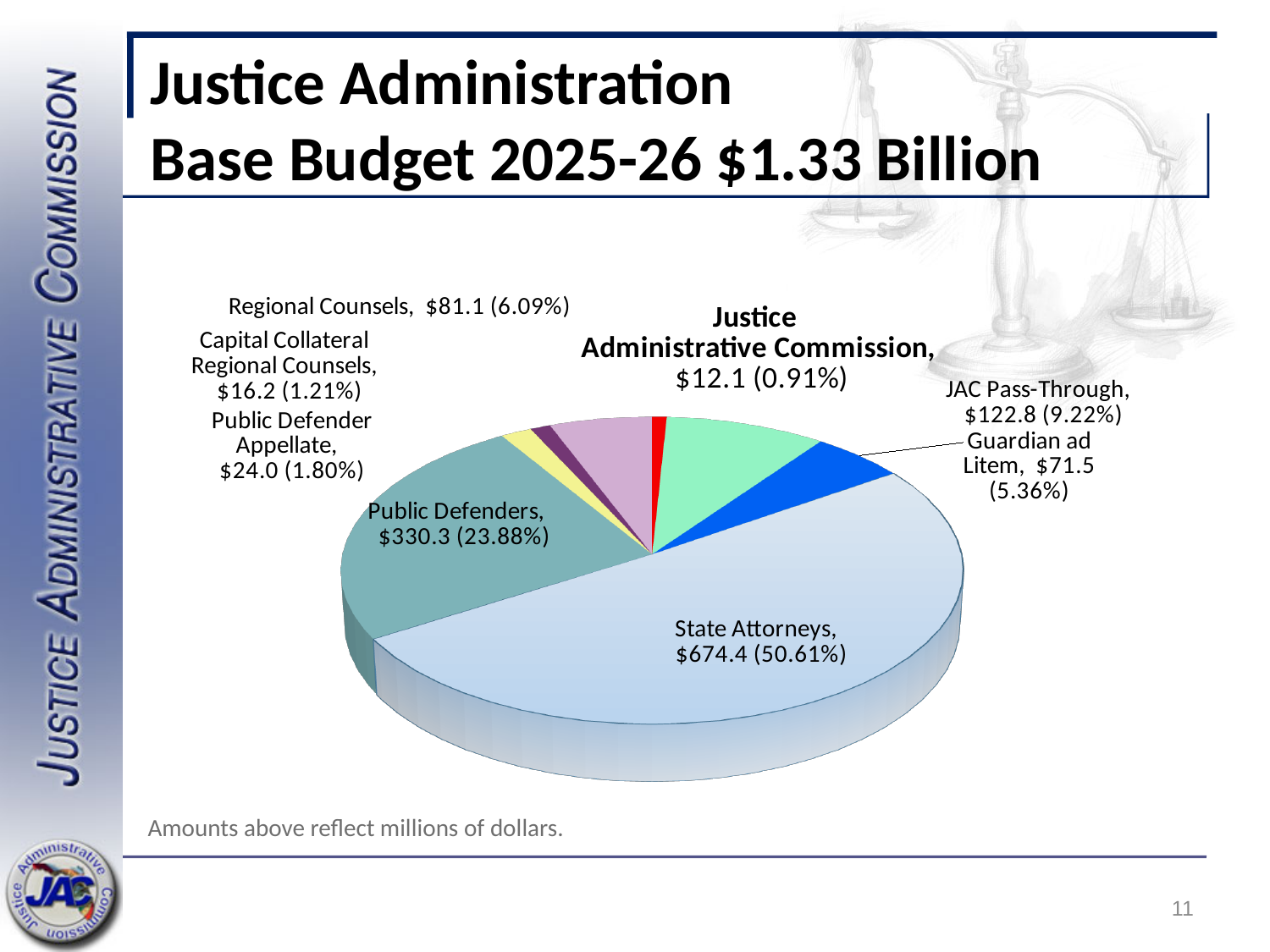
What share of the pie does Regional Counsels represent? 6.09% What is the value for Public Defenders? $330.3 What kind of chart is shown on the slide? Pie chart What is the difference between the values for State Attorneys and Public Defenders? $344.1 Which category has the largest slice of the pie? State Attorneys What is the value for State Attorneys? $674.4 What share of the pie does Justice Administrative Commission represent? 0.91% Which category has the smallest slice of the pie? Justice Administrative Commission What is the value for JAC Pass-Through? $122.8 What is the value for Guardian ad Litem? $71.5 How many slices does the pie chart have? 8 Which is larger, the value for Public Defender Appellate or the value for Capital Collateral Regional Counsels? Public Defender Appellate